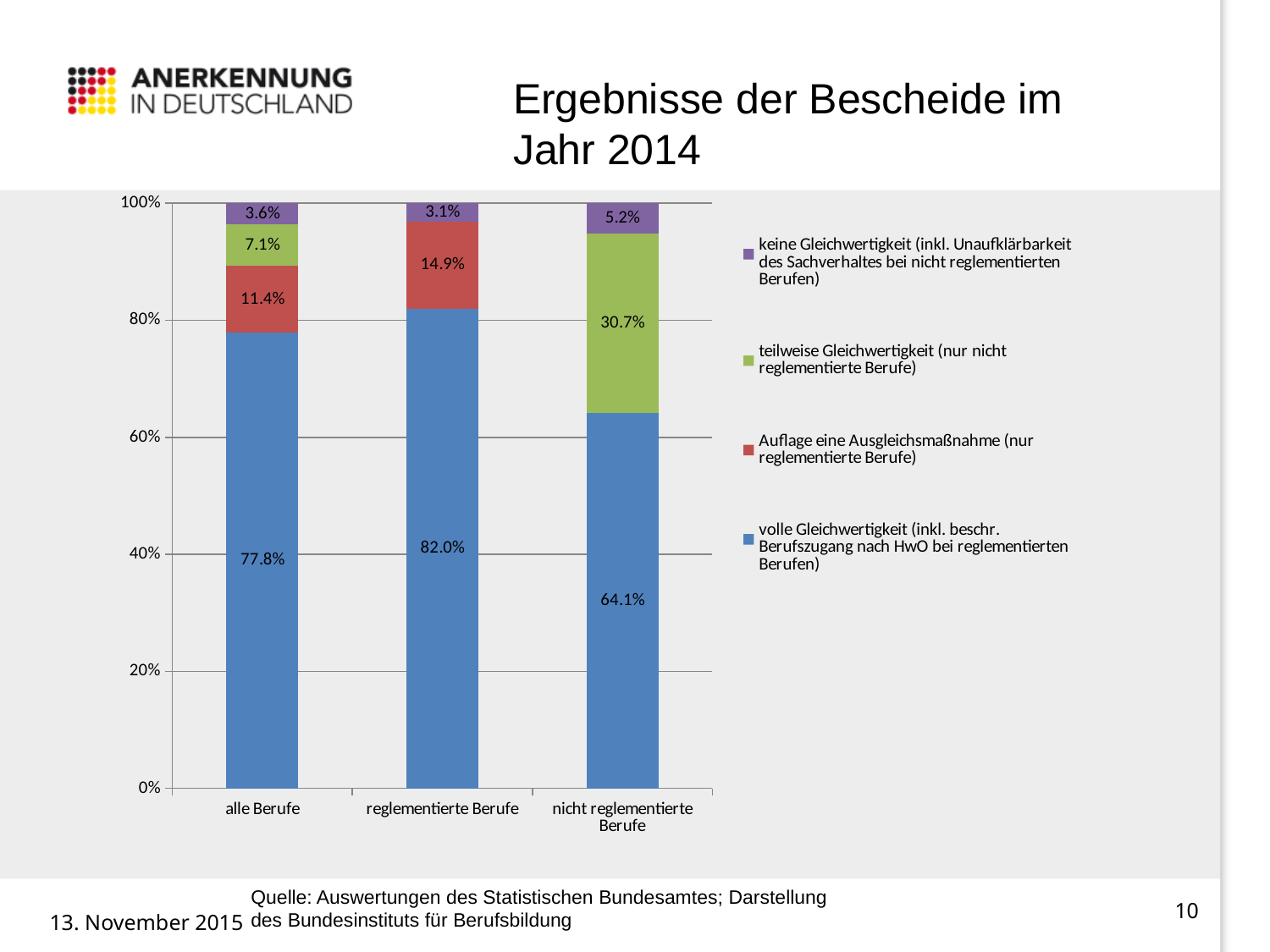
What is the value for volle Gleichwertigkeit for alle Berufe? 77.8% Which is larger: the Auflage eine Ausgleichsmaßnahme value for alle Berufe or for reglementierte Berufe? reglementierte Berufe What is the value for Auflage eine Ausgleichsmaßnahme for reglementierte Berufe? 14.9% What is the difference between the volle Gleichwertigkeit values for reglementierte Berufe and nicht reglementierte Berufe? 17.9% Which category has the highest value for volle Gleichwertigkeit? reglementierte Berufe What is the value for keine Gleichwertigkeit for alle Berufe? 3.6% How many series does the legend list? 4 How many categories are shown on the x axis? 3 What kind of chart is shown on the slide? stacked bar chart Which category has the lowest value for keine Gleichwertigkeit? reglementierte Berufe What is the value for teilweise Gleichwertigkeit for nicht reglementierte Berufe? 30.7% What is the title of the slide? Ergebnisse der Bescheide im Jahr 2014